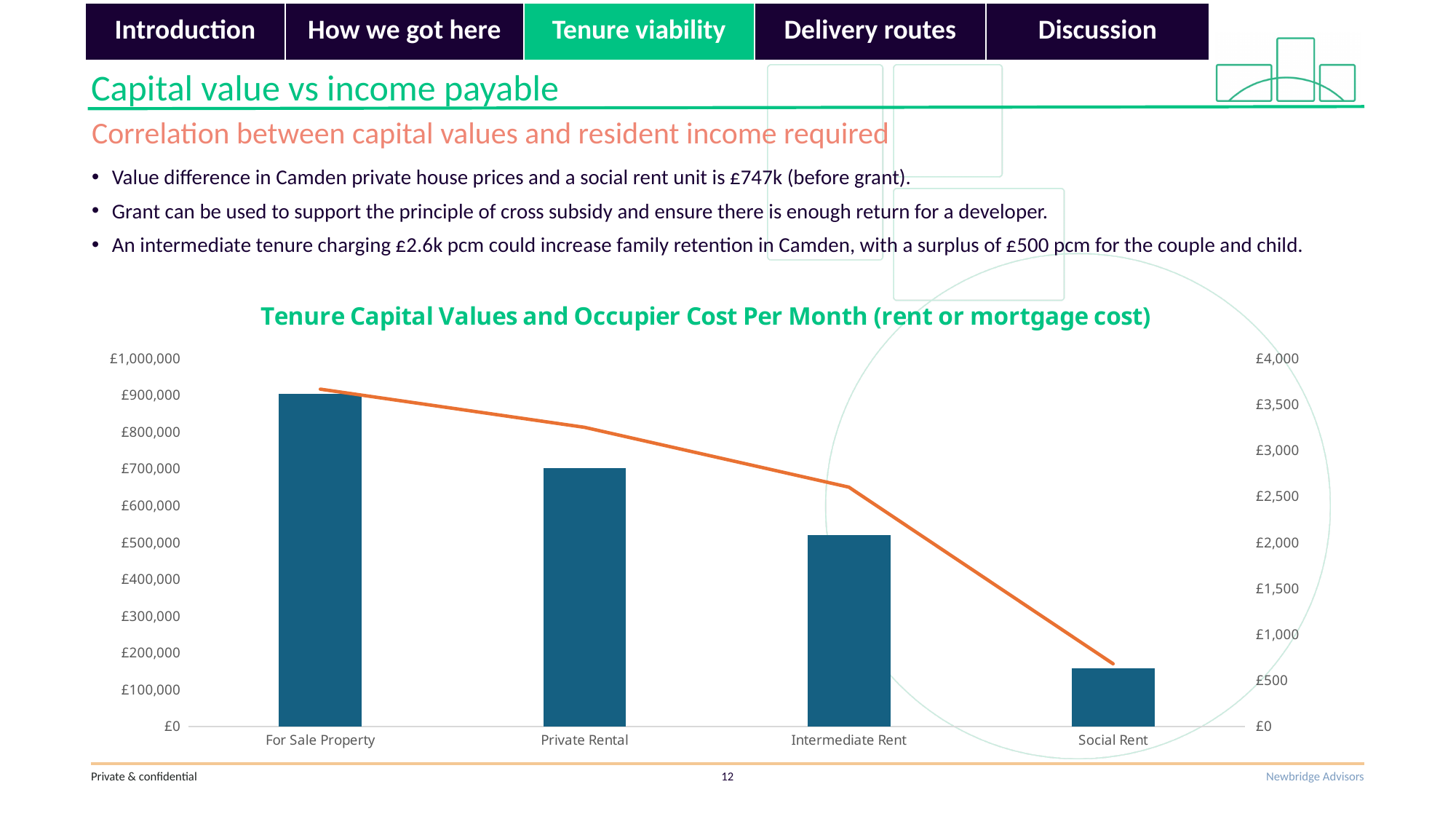
Is the capital value bar for Intermediate Rent greater or less than £600,000? less How many tenure categories are shown on the x axis of the chart? 4 Which tenure has the lowest capital value bar? Social Rent Does the occupier cost per month line rise or fall from For Sale Property to Social Rent? fall Is the capital value bar for Social Rent greater or less than £200,000? less Which tenure has the highest capital value bar? For Sale Property Is the capital value bar for For Sale Property greater or less than £800,000? greater Which has the larger capital value bar, Private Rental or Intermediate Rent? Private Rental What type of chart is shown on the slide? Combined bar and line chart Which tenure has the lowest point on the occupier cost per month line? Social Rent Do the capital value bars rise or fall from left to right across the x axis? fall What is the title of the chart? Tenure Capital Values and Occupier Cost Per Month (rent or mortgage cost)